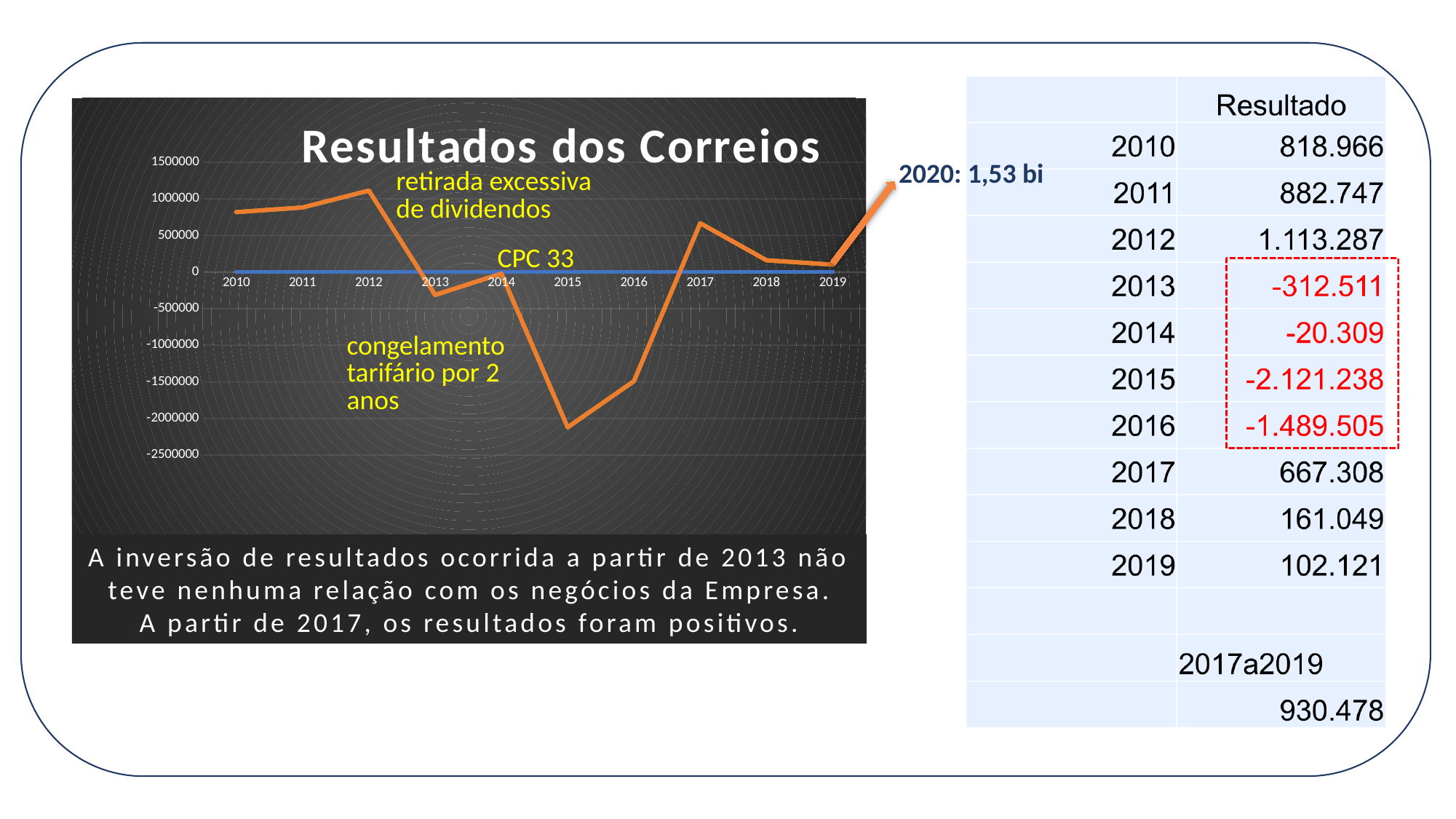
Which year has the highest result in the chart? 2012 What is the result for 2012 according to the slide? 1.113.287 How many years are plotted along the x axis of the chart? 10 Which is larger, the result for 2017 or the result for 2018? 2017 What is the difference between the results for 2011 and 2010? 63.781 What is the title of the chart? Resultados dos Correios What kind of chart is shown on the slide? line chart What is the result for 2015 according to the slide? -2.121.238 What is the result for 2019 according to the slide? 102.121 Do the values rise or fall from 2012 to 2015? fall Is the value for 2015 greater or less than -2000000? less Which year has the lowest result in the chart? 2015